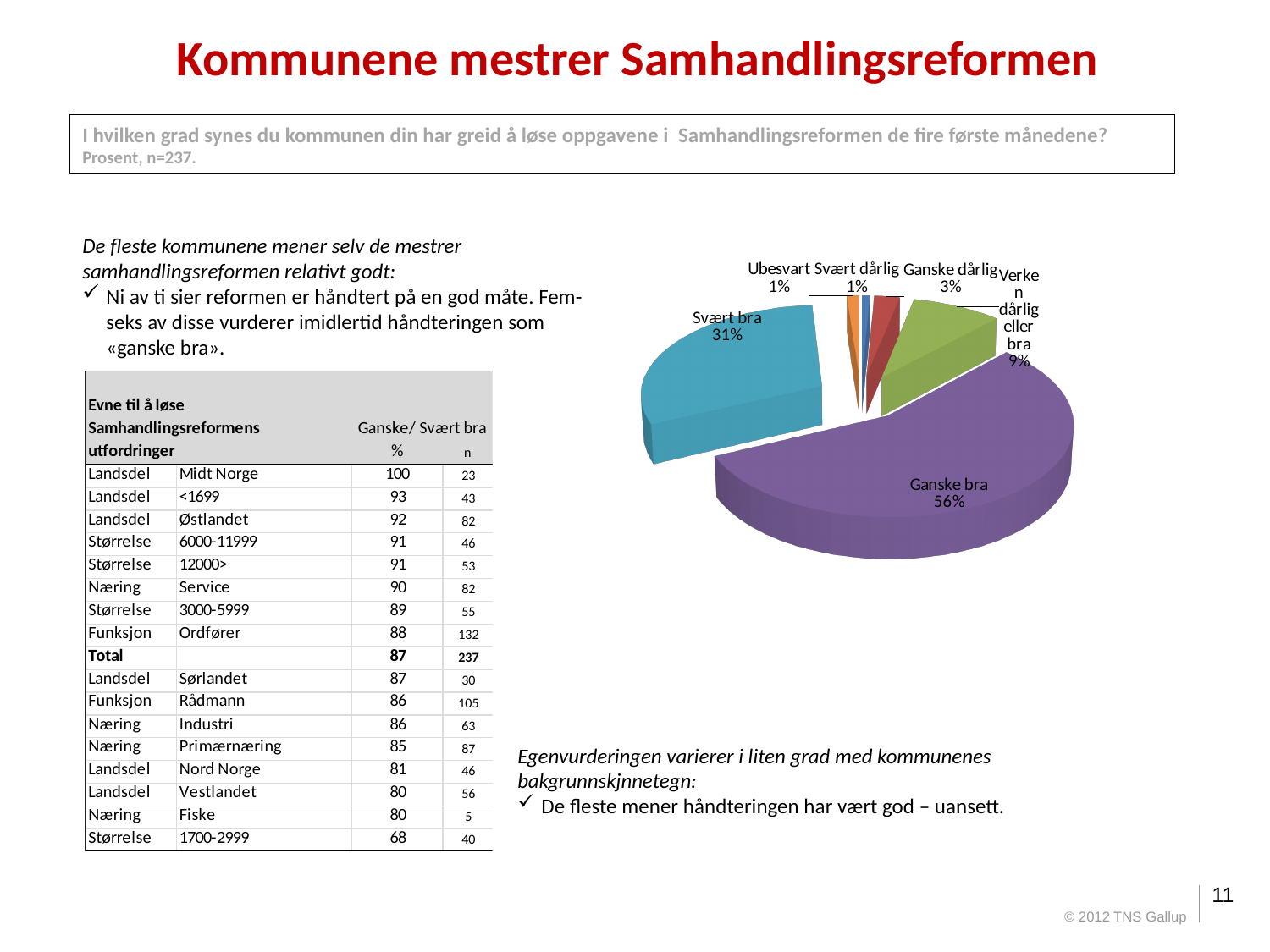
What share of the pie does "Verken dårlig eller bra" have? 9% How many slices does the pie chart have? 6 What share of the pie does "Ubesvart" have? 1% What is the combined share of "Ganske bra" and "Svært bra"? 87% What kind of chart is shown on the slide? pie chart What share of the pie does "Svært bra" have? 31% Which is larger, the share for "Verken dårlig eller bra" or the share for "Ganske dårlig"? Verken dårlig eller bra Which slice of the pie chart is the largest? Ganske bra What is the difference in percentage points between "Ganske bra" and "Svært bra"? 25 What colour is the "Ganske bra" slice in the pie chart? purple